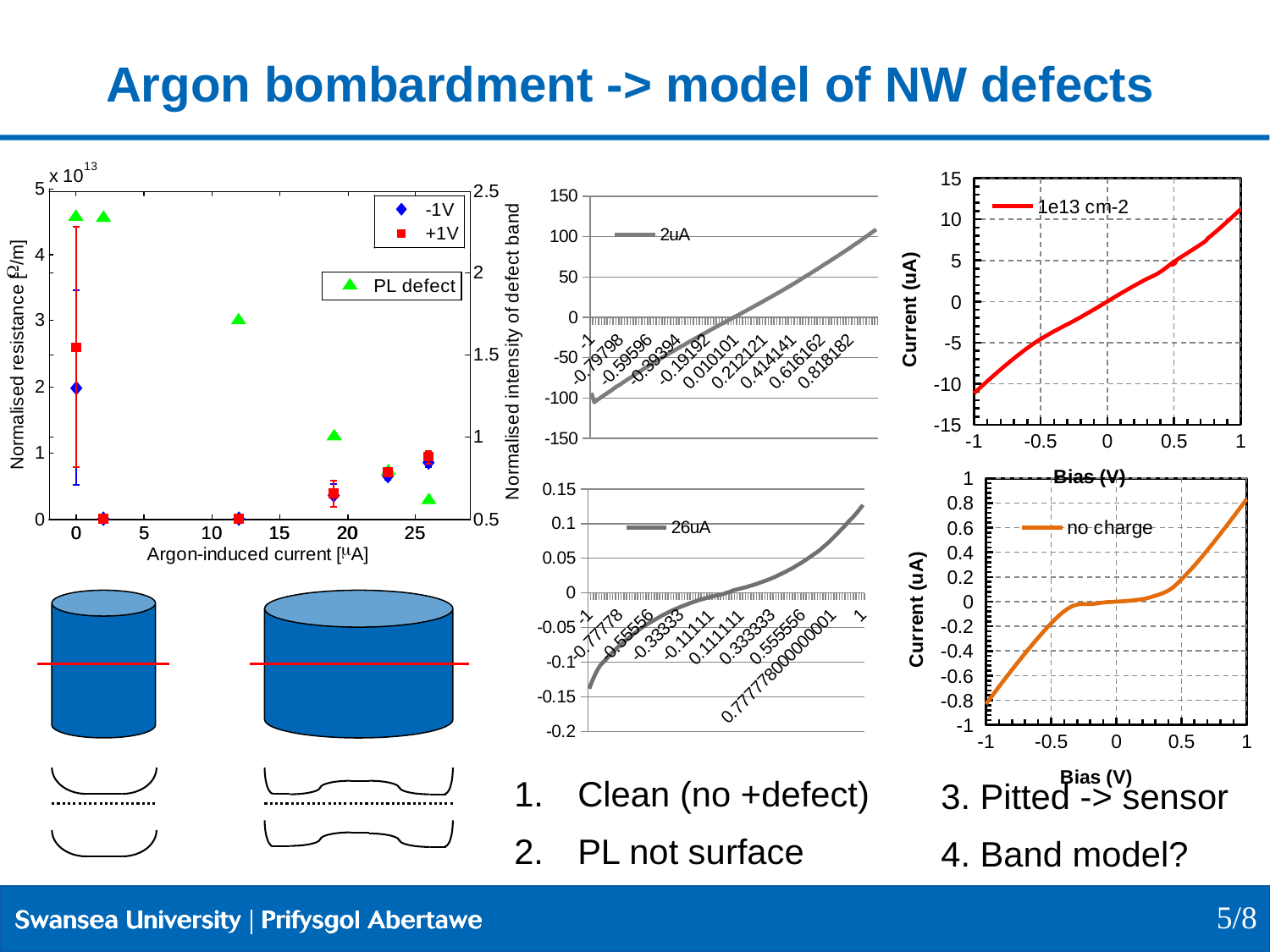
In the top-left chart, is the PL defect value at 12 µA greater or less than 1.5 on the right-hand axis? greater What is the x-axis label of the top-left chart? Argon-induced current [µA] In the middle-bottom chart (26uA), is the value at x = 1 greater or less than 0.05? greater What kind of chart is the middle-top chart labelled 2uA? line chart In the top-right chart, what is the legend entry for the red line? 1e13 cm-2 In the top-left chart, what are the three legend entries? -1V, +1V, PL defect In the middle-top chart (2uA), does the line rise or fall along the x axis? rise In the top-left chart, how many series does the legend list? 3 In the bottom-right chart (no charge), is the current at a bias of 1 V greater or less than 0.6 uA? greater In the top-left chart, does the PL defect series rise or fall as the argon-induced current increases? fall